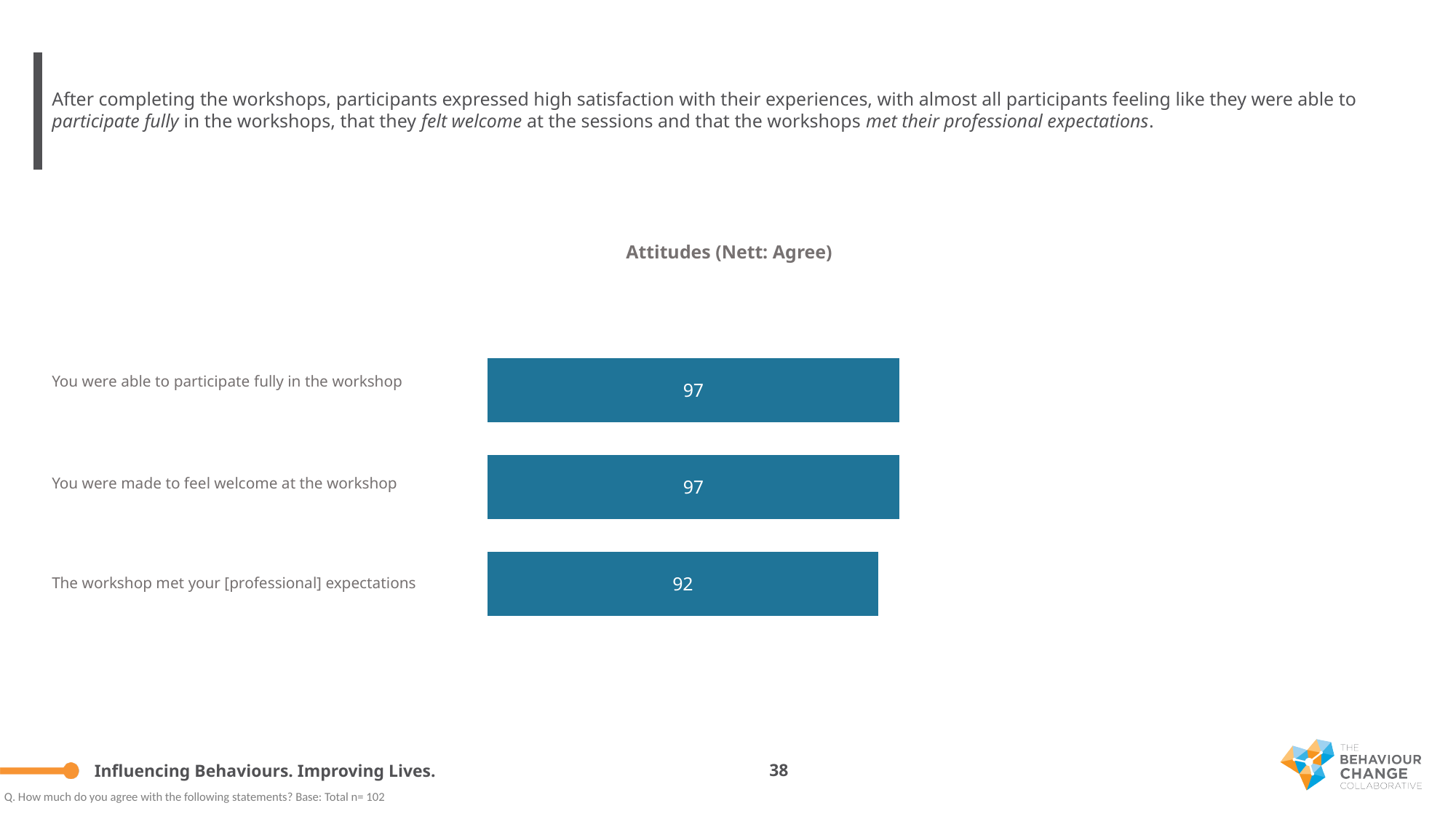
Do the values for "You were able to participate fully in the workshop" and "You were made to feel welcome at the workshop" have the same value? Yes Which statement has the lowest value? The workshop met your [professional] expectations What is the value for "The workshop met your [professional] expectations"? 92 Which is larger: the value for "You were able to participate fully in the workshop" or the value for "The workshop met your [professional] expectations"? You were able to participate fully in the workshop What is the value for "You were made to feel welcome at the workshop"? 97 How many statements are shown in the chart? 3 What is the difference between the value for "You were made to feel welcome at the workshop" and the value for "The workshop met your [professional] expectations"? 5 What colour are the bars in the chart? Blue What kind of chart is shown on the slide? Bar chart What is the title of the chart? Attitudes (Nett: Agree) What is the value for "You were able to participate fully in the workshop"? 97